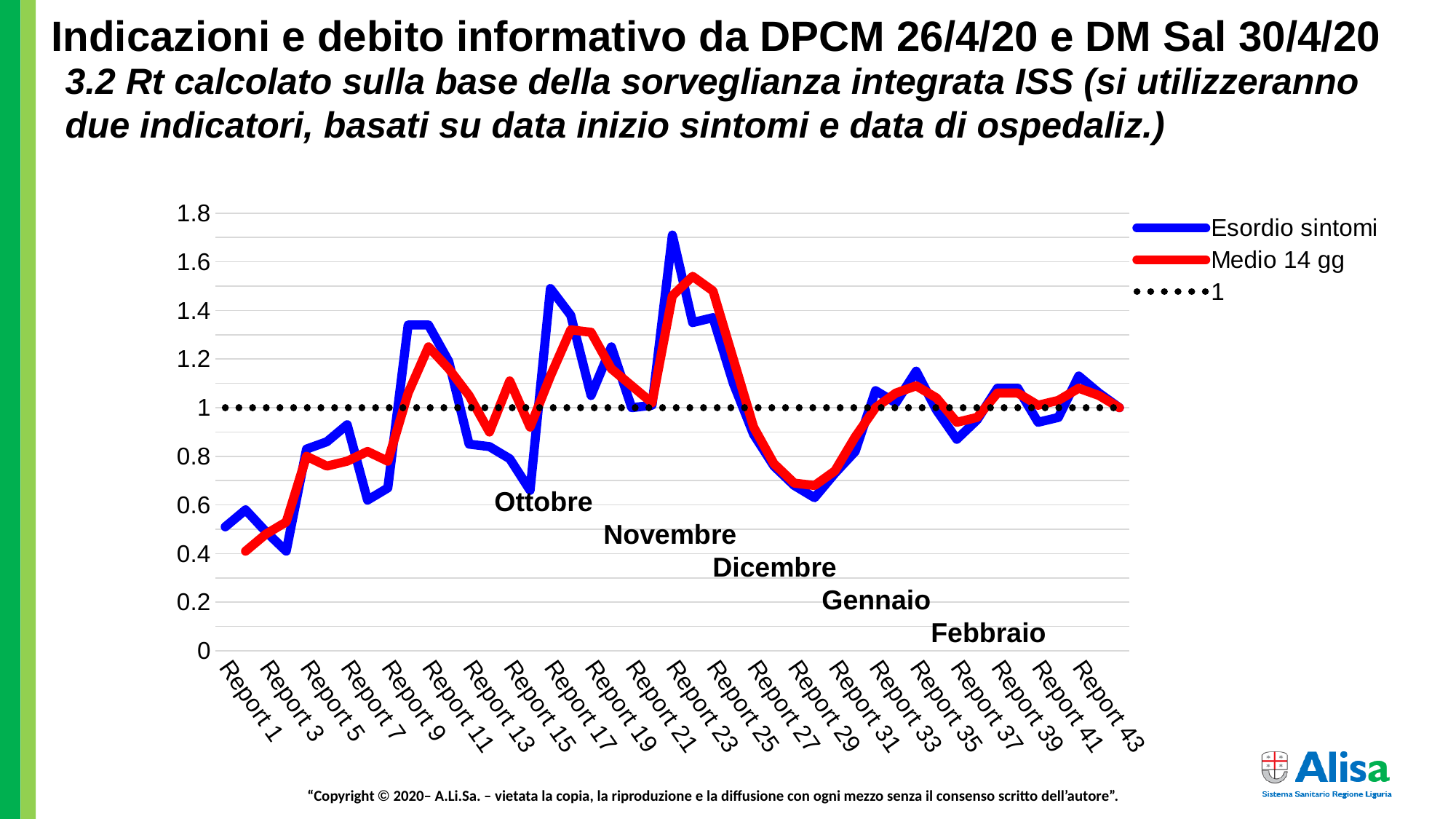
Is the value of Esordio sintomi at Report 1 greater or less than 0.6? less At Report 21, which series has the larger value, Esordio sintomi or Medio 14 gg? Medio 14 gg Is the value of Medio 14 gg at Report 23 greater or less than 1.4? greater Is the highest value reached by Esordio sintomi greater or less than 1.6? greater Between Report 23 and Report 27, does the Esordio sintomi line rise or fall? fall What kind of chart is shown on the slide? line chart How many entries does the chart legend list? 3 What value does the dotted black reference line mark on the chart? 1 At Report 13, which series has the larger value, Esordio sintomi or Medio 14 gg? Medio 14 gg Which series is drawn in red in the chart? Medio 14 gg